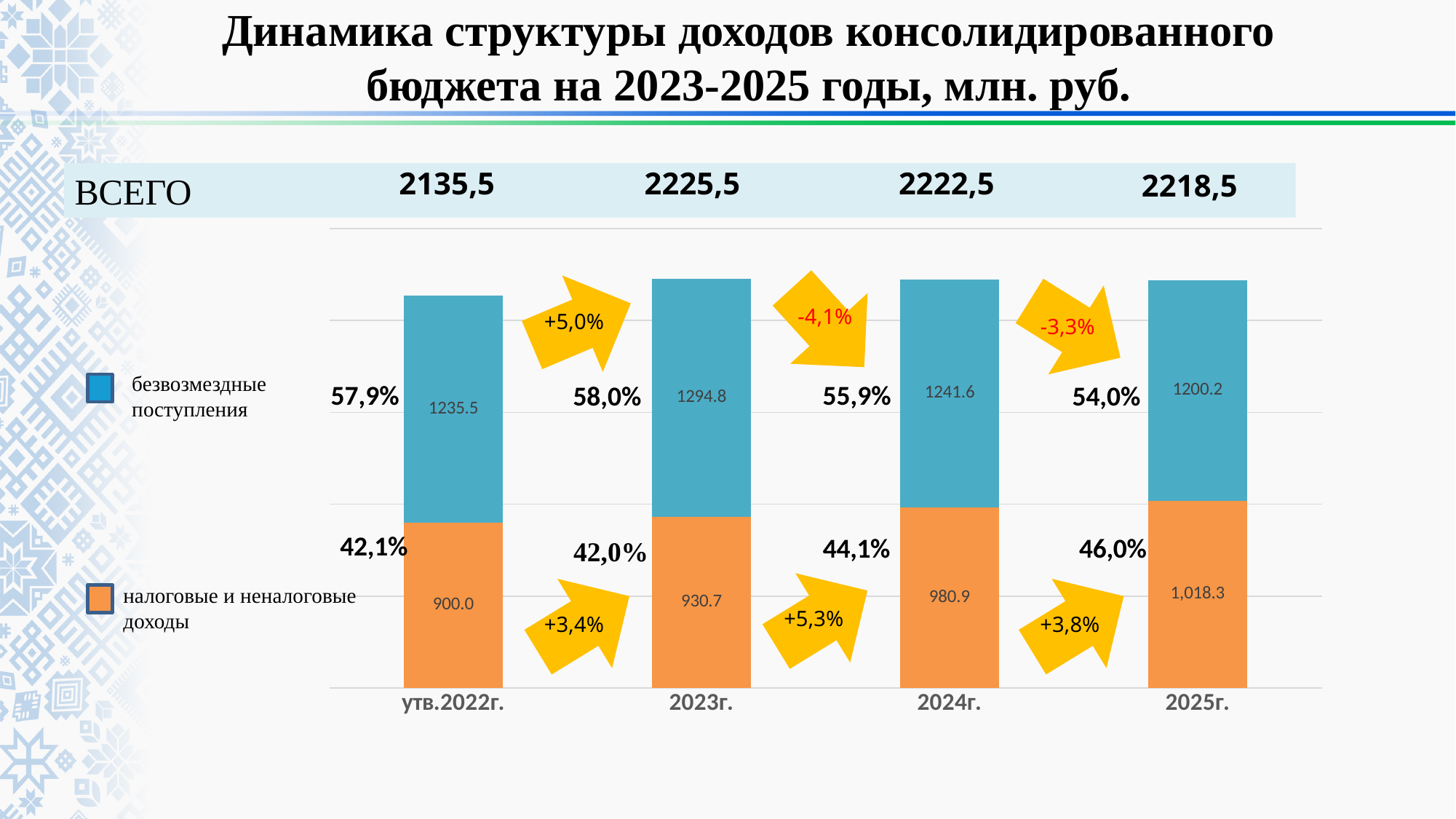
How many years (categories) are shown on the x axis? 4 What kind of chart is shown on the slide? stacked bar chart What is the total (ВСЕГО) of the stacked bar for 2024г.? 2222,5 In which year is безвозмездные поступления highest? 2023г. What is the value of безвозмездные поступления for 2023г.? 1294.8 What is the value of налоговые и неналоговые доходы for 2025г.? 1,018.3 What is the value of налоговые и неналоговые доходы for утв.2022г.? 900.0 In which year is налоговые и неналоговые доходы lowest? утв.2022г. Do the values of налоговые и неналоговые доходы rise or fall from утв.2022г. to 2025г.? rise What is the difference between безвозмездные поступления in 2023г. and in 2025г.? 94.6 How many series does the legend list? 2 Which is larger: налоговые и неналоговые доходы in 2024г. or in 2023г.? 2024г.